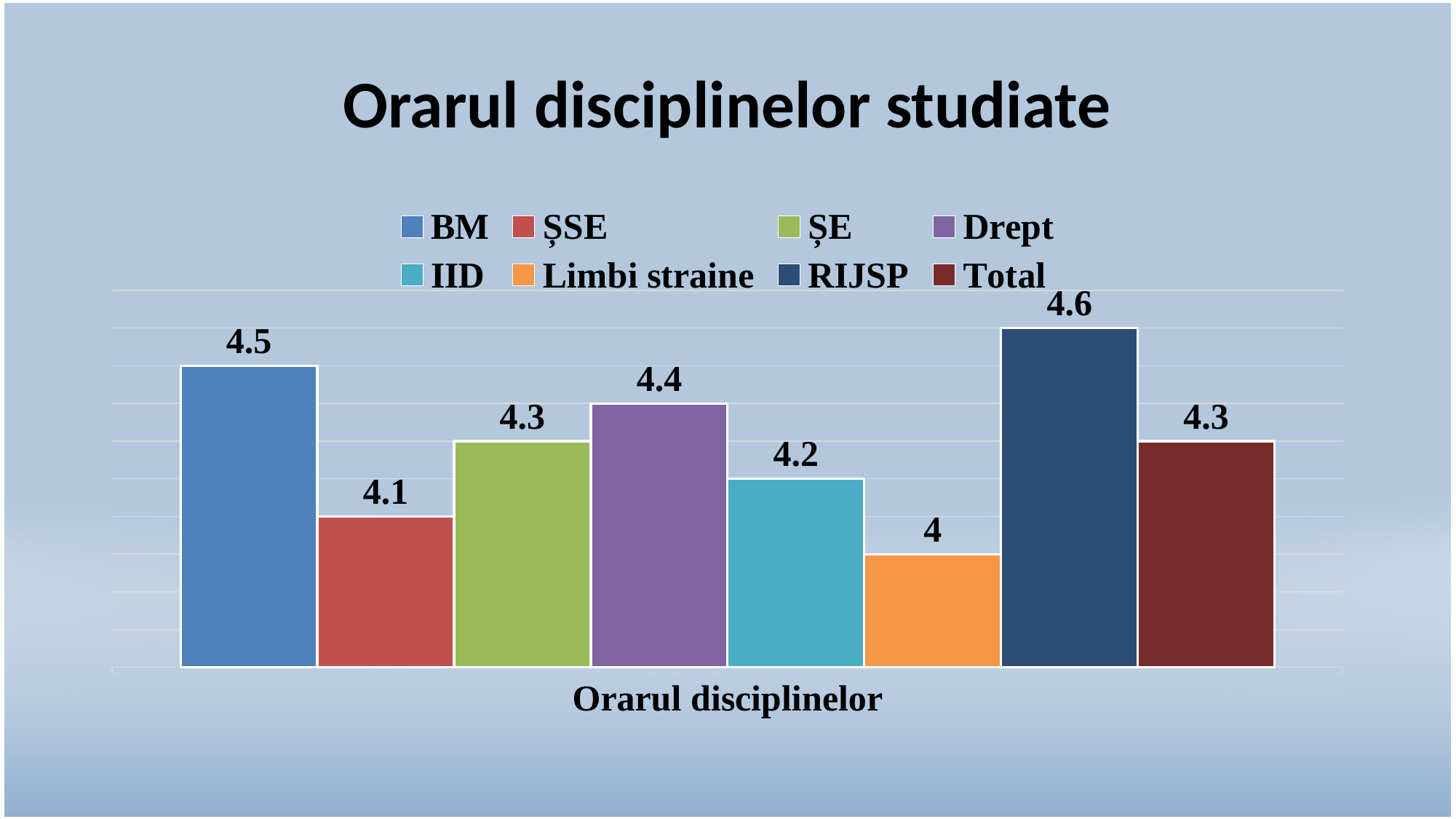
What is the difference between the values for BM and ȘSE? 0.4 What is the value for Limbi straine? 4 What is the value for Total? 4.3 What is the value for BM? 4.5 What kind of chart is shown on the slide? Bar chart What is the difference between the values for RIJSP and Limbi straine? 0.6 How many series does the legend list? 8 What is the value for RIJSP? 4.6 What is the title of the chart? Orarul disciplinelor studiate Which series has the highest value? RIJSP Which series has the lowest value? Limbi straine Which is larger, the value for Drept or the value for IID? Drept